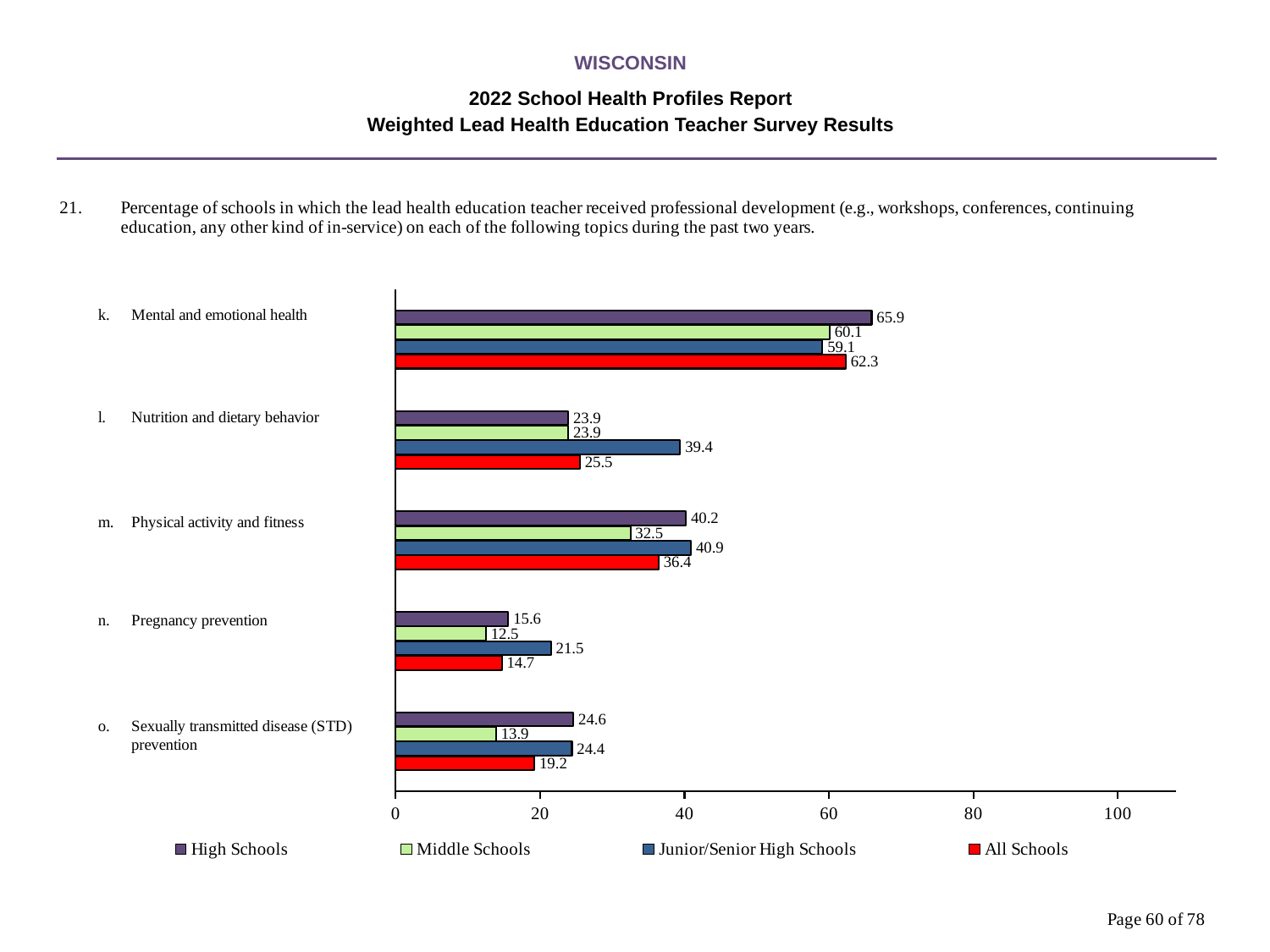
What is the value for All Schools for Pregnancy prevention? 14.7 What is the value for High Schools for Mental and emotional health? 65.9 How many topics are shown on the chart? 5 What is the value for Junior/Senior High Schools for Nutrition and dietary behavior? 39.4 Which is larger for Nutrition and dietary behavior: the Junior/Senior High Schools value or the All Schools value? Junior/Senior High Schools How many series does the legend list? 4 What kind of chart is shown on the slide? Bar chart What is the difference between the High Schools and Middle Schools values for Physical activity and fitness? 7.7 Which topic has the highest value for All Schools? Mental and emotional health Which topic has the lowest value for Middle Schools? Pregnancy prevention What is the value for Middle Schools for Sexually transmitted disease (STD) prevention? 13.9 Which series is shown in red in the legend? All Schools